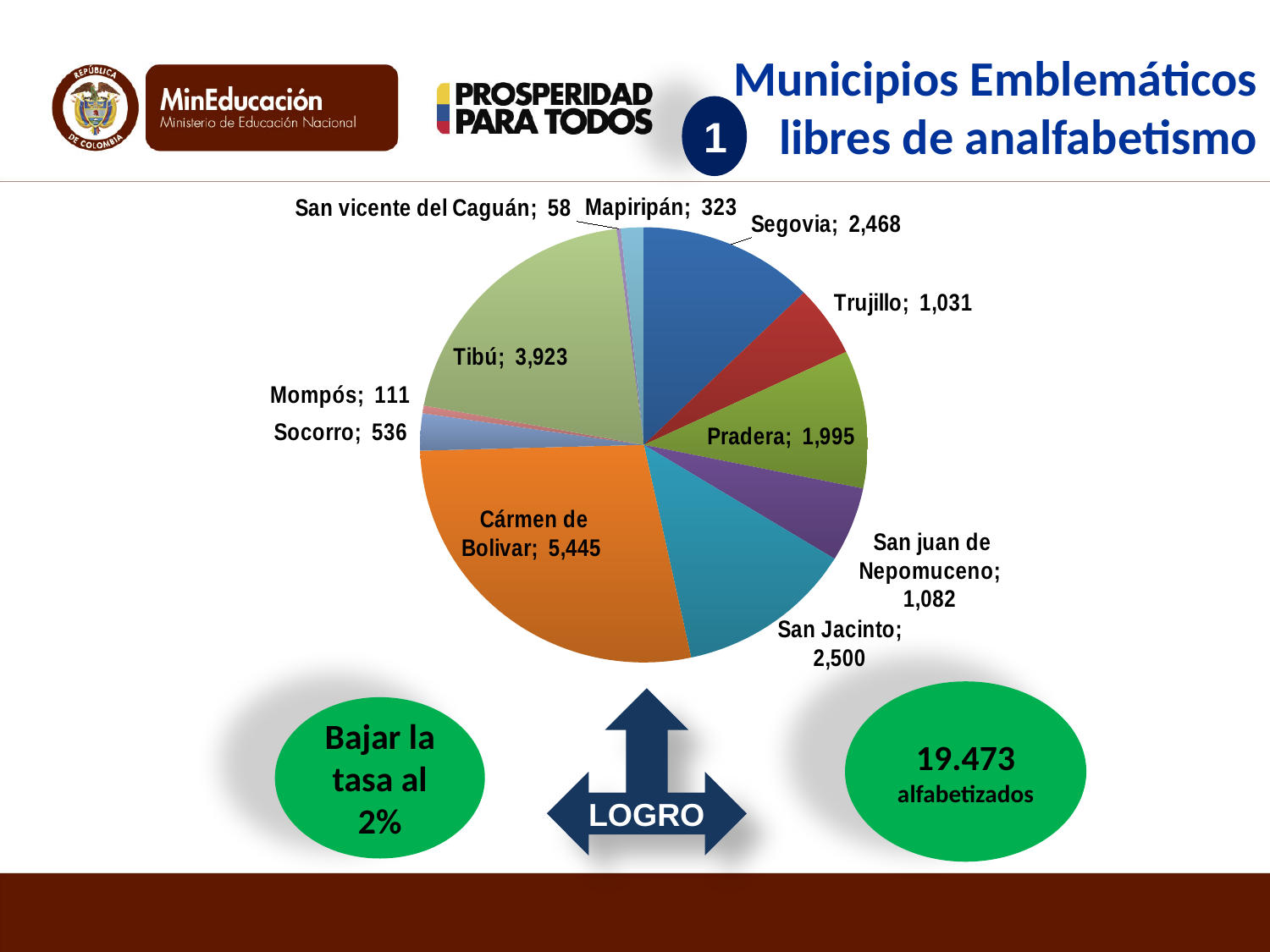
Which municipality has the smallest slice in the pie chart? San vicente del Caguán Which municipality has the largest slice in the pie chart? Cármen de Bolivar What value is shown for Mapiripán in the pie chart? 323 What kind of chart is shown on the slide? Pie chart What value is shown for San Jacinto in the pie chart? 2,500 What is the difference between the values for San Jacinto and Segovia? 32 What value is shown for San juan de Nepomuceno in the pie chart? 1,082 Which is larger, the value for Pradera or the value for Trujillo? Pradera How many municipalities are shown in the pie chart? 11 What value is shown for Tibú in the pie chart? 3,923 What is the difference between the values for Cármen de Bolivar and Tibú? 1,522 Which is larger, the value for Socorro or the value for Mompós? Socorro